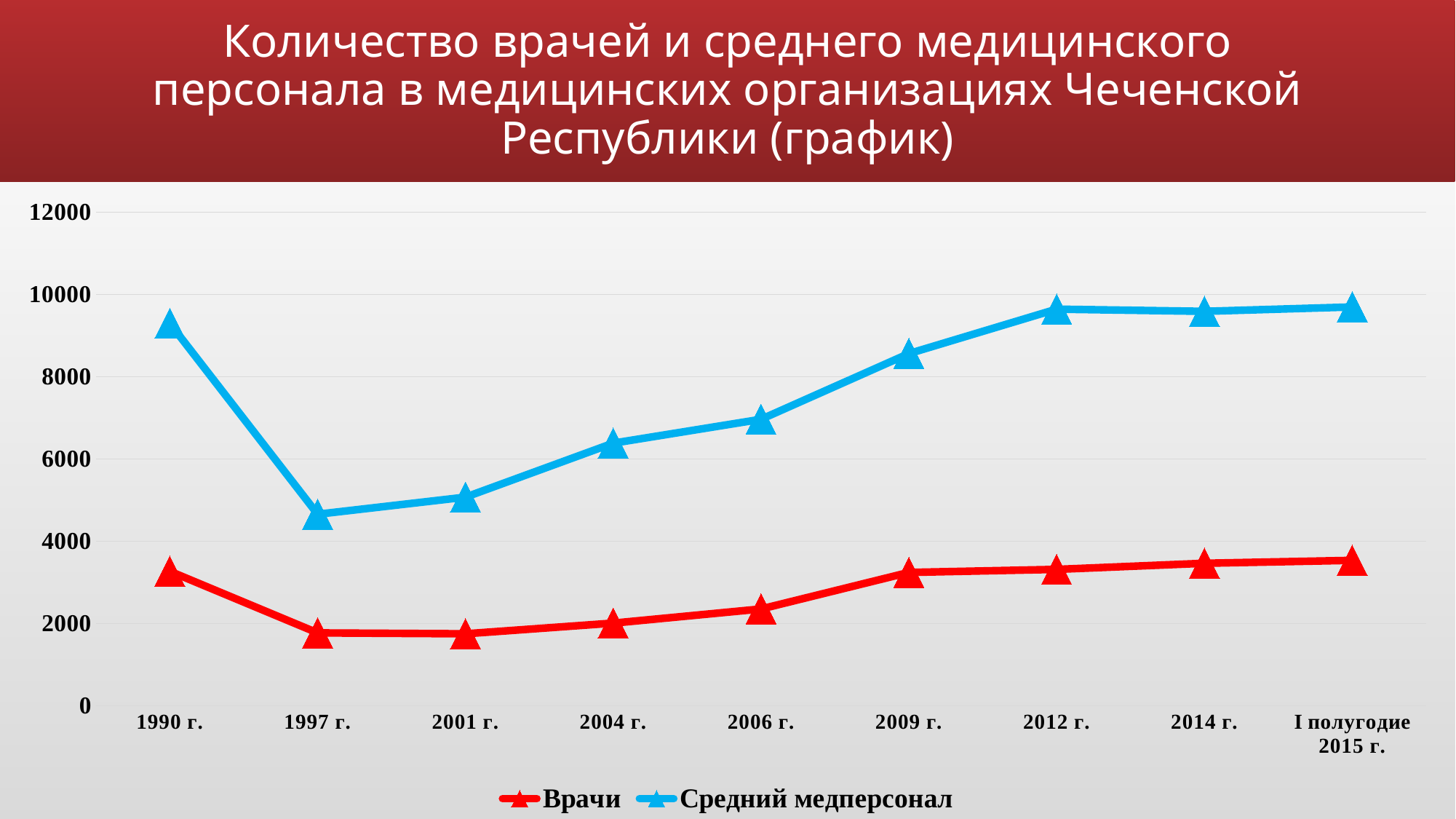
Which is larger for Средний медперсонал: the value in 1990 г. or in 2009 г.? 1990 г. Is the value for Средний медперсонал in 1990 г. greater or less than 8000? greater Which series is shown in blue? Средний медперсонал How many series does the legend list? 2 Is the value for Врачи in 2009 г. greater or less than 2000? greater Is the value for Средний медперсонал in 1997 г. greater or less than 6000? less In which year is the value for Средний медперсонал lowest? 1997 г. How many time points are plotted along the x axis? 9 Does the value for Средний медперсонал rise or fall from 1997 г. to 2012 г.? rise What kind of chart is shown on the slide? line chart